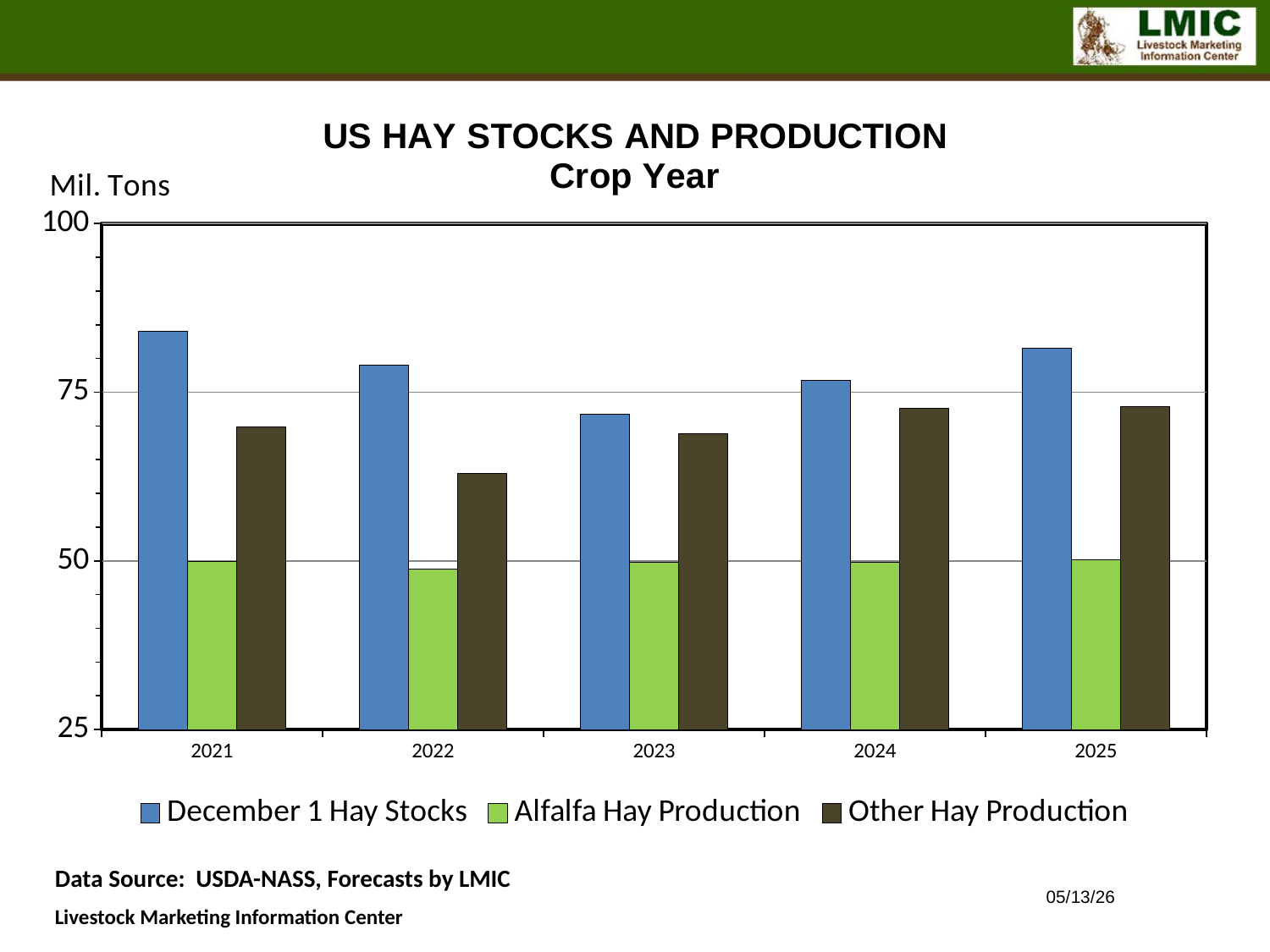
In 2022, which is larger: Other Hay Production or Alfalfa Hay Production? Other Hay Production How many series does the legend list? 3 How many crop years are shown on the x axis? 5 In which crop year is December 1 Hay Stocks lowest? 2023 What kind of chart is shown on the slide? bar chart Is the value for December 1 Hay Stocks in 2023 greater or less than 75? less Does December 1 Hay Stocks rise or fall from 2021 to 2023? fall Is the value for Other Hay Production in 2022 greater or less than 75? less In which crop year is Other Hay Production lowest? 2022 In which crop year is December 1 Hay Stocks highest? 2021 What unit is shown on the y axis label? Mil. Tons Is the value for December 1 Hay Stocks in 2021 greater or less than 75? greater